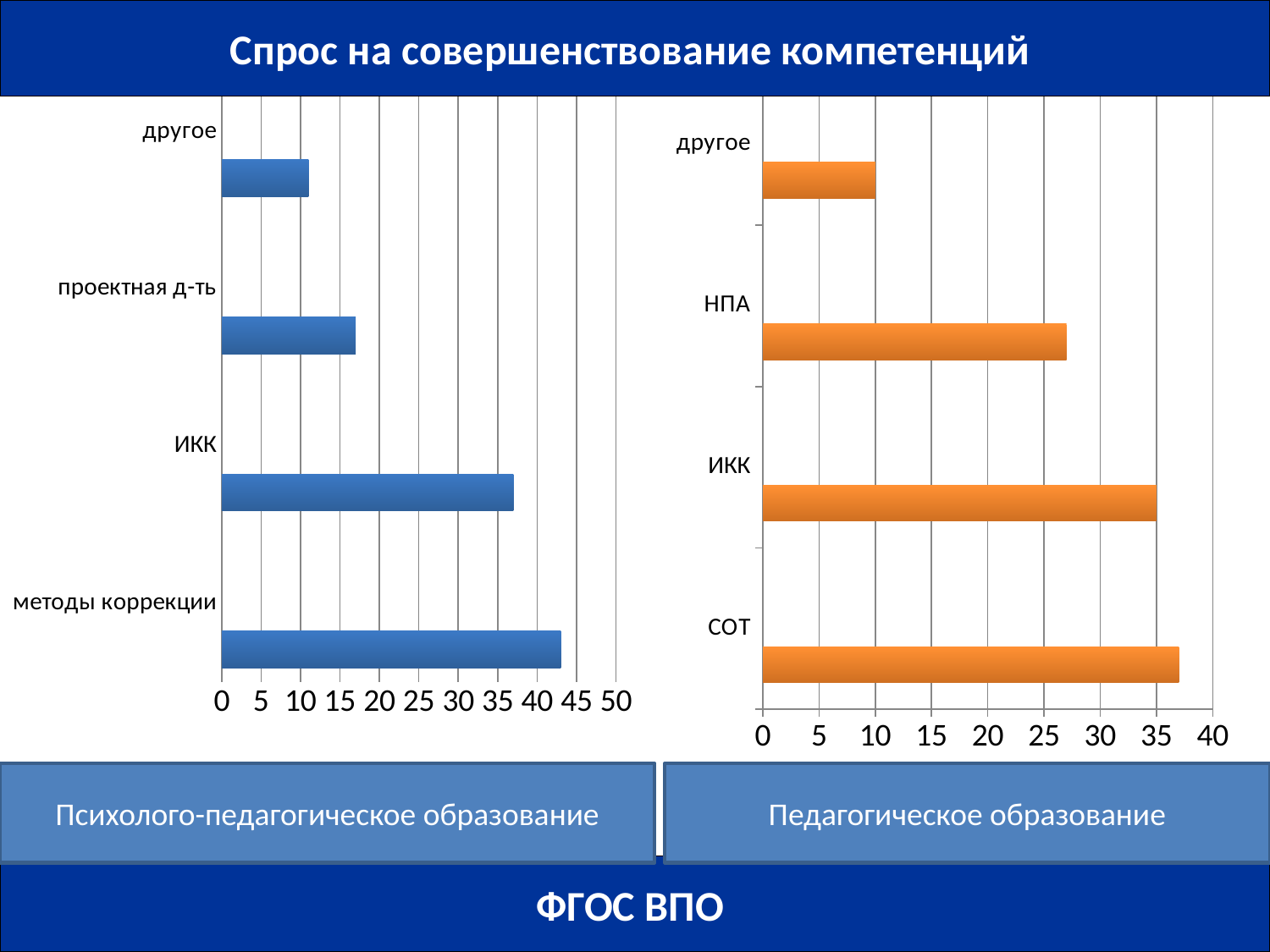
How many categories are shown in the left chart? 4 In the left chart, which category has the lowest value? другое What is the title shown at the top of the slide above the charts? Спрос на совершенствование компетенций In the right chart, which category has the lowest value? другое In the right chart, what is the value for ИКК? 35 In the right chart, is the value for НПА greater or less than 25? greater In the right chart (Педагогическое образование), what is the value for другое? 10 In the left chart, which category has the highest value? методы коррекции In the left chart, is the value for методы коррекции greater or less than 40? greater In the left chart, is the value for проектная д-ть greater or less than 20? less What kind of chart is the left chart (Психолого-педагогическое образование)? bar chart In the left chart, which is larger: ИКК or проектная д-ть? ИКК